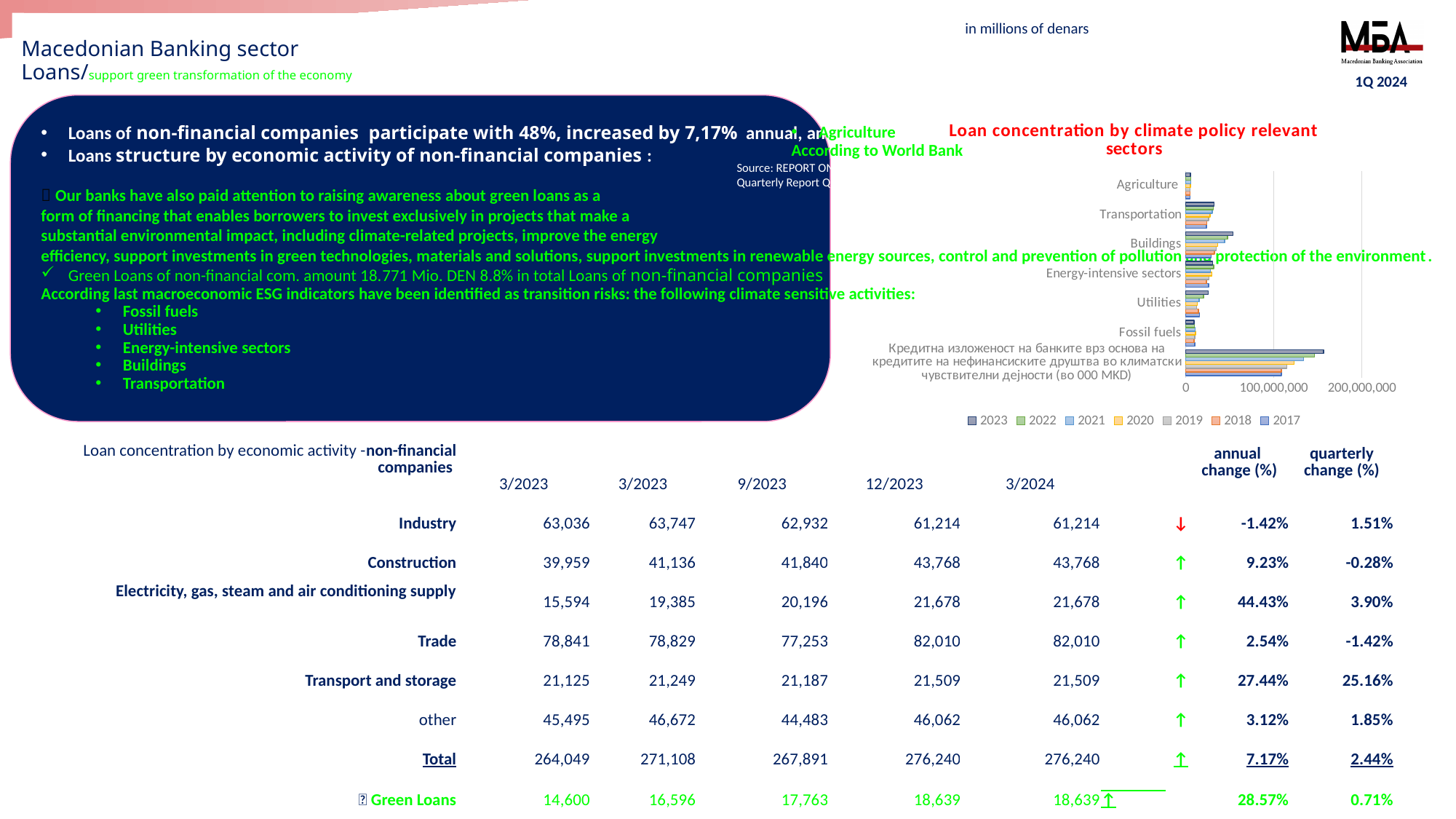
In the chart, which has larger bars: Buildings or Agriculture? Buildings In the chart, is the 2023 value for the bottom category (total credit exposure to climate-sensitive activities) greater or less than 100,000,000? greater In the chart, which has larger bars: Transportation or Fossil fuels? Transportation What is the highest tick label shown on the horizontal axis of the chart? 200,000,000 How many categories are plotted on the vertical axis of the 'Loan concentration by climate policy relevant sectors' chart? 7 Which category in the 'Loan concentration by climate policy relevant sectors' chart has the shortest bars? Agriculture How many series does the legend of the 'Loan concentration by climate policy relevant sectors' chart list? 7 Among the named sectors (Agriculture, Transportation, Buildings, Energy-intensive sectors, Utilities, Fossil fuels) in the chart, which has the longest bars? Buildings Which year is listed first in the legend of the chart? 2023 What kind of chart is shown under the title 'Loan concentration by climate policy relevant sectors'? bar chart For the bottom category of the chart, do the bars rise or fall from 2017 to 2023? rise In the chart, is the 2023 value for Buildings greater or less than 100,000,000? less